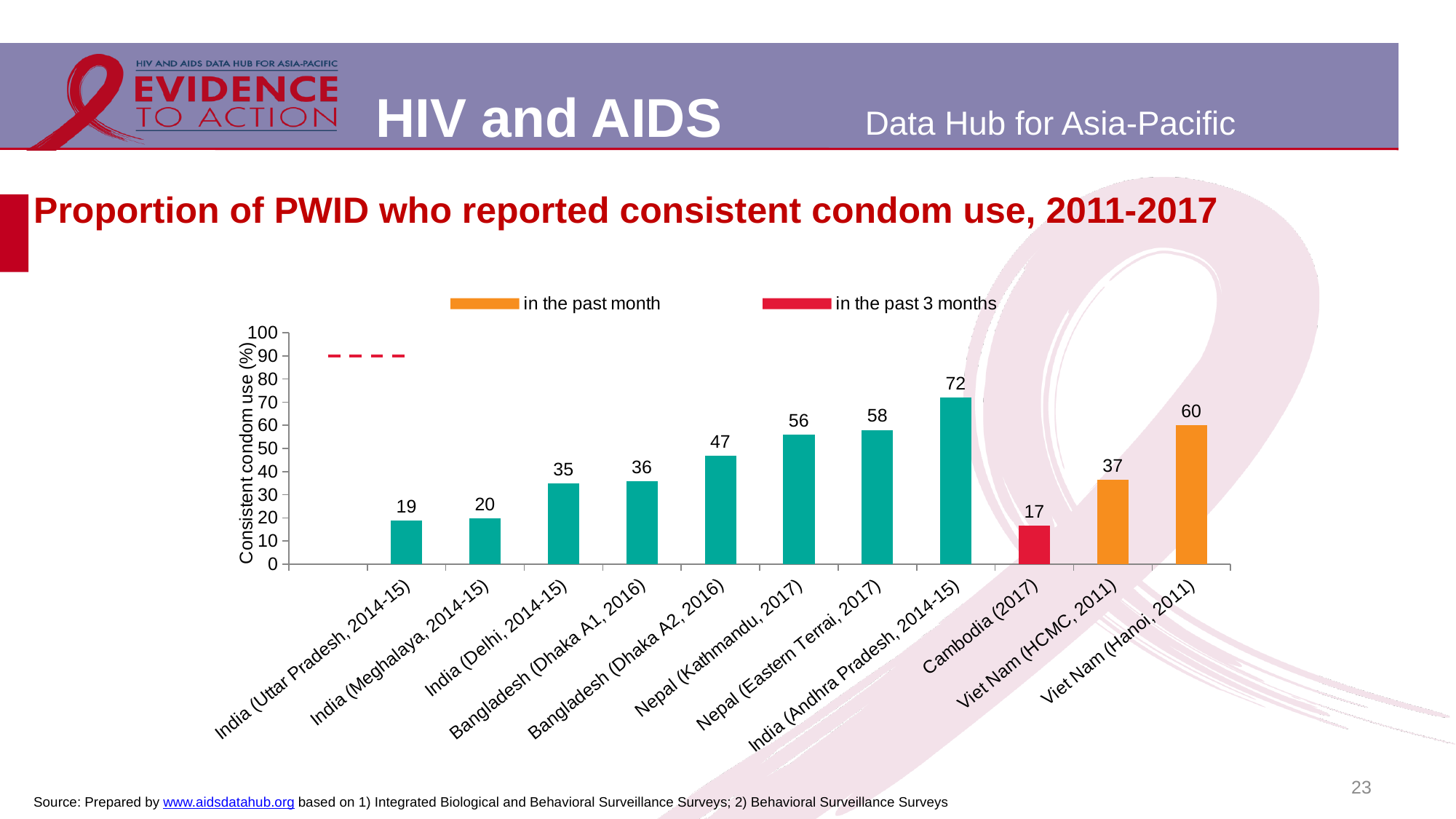
Which is larger, the value for Viet Nam (HCMC, 2011) or the value for Bangladesh (Dhaka A2, 2016)? Bangladesh (Dhaka A2, 2016) What is the value for India (Andhra Pradesh, 2014-15)? 72 How many categories are shown on the x axis? 11 What is the value for Viet Nam (Hanoi, 2011)? 60 Which category has the highest value? India (Andhra Pradesh, 2014-15) How many series does the legend list? 2 Which category has the lowest value? Cambodia (2017) What is the label of the y axis? Consistent condom use (%) What is the difference between the values for Nepal (Eastern Terrai, 2017) and Nepal (Kathmandu, 2017)? 2 What is the value for Cambodia (2017)? 17 Is the value for India (Delhi, 2014-15) greater or less than 30? greater What kind of chart is shown on the slide? bar chart